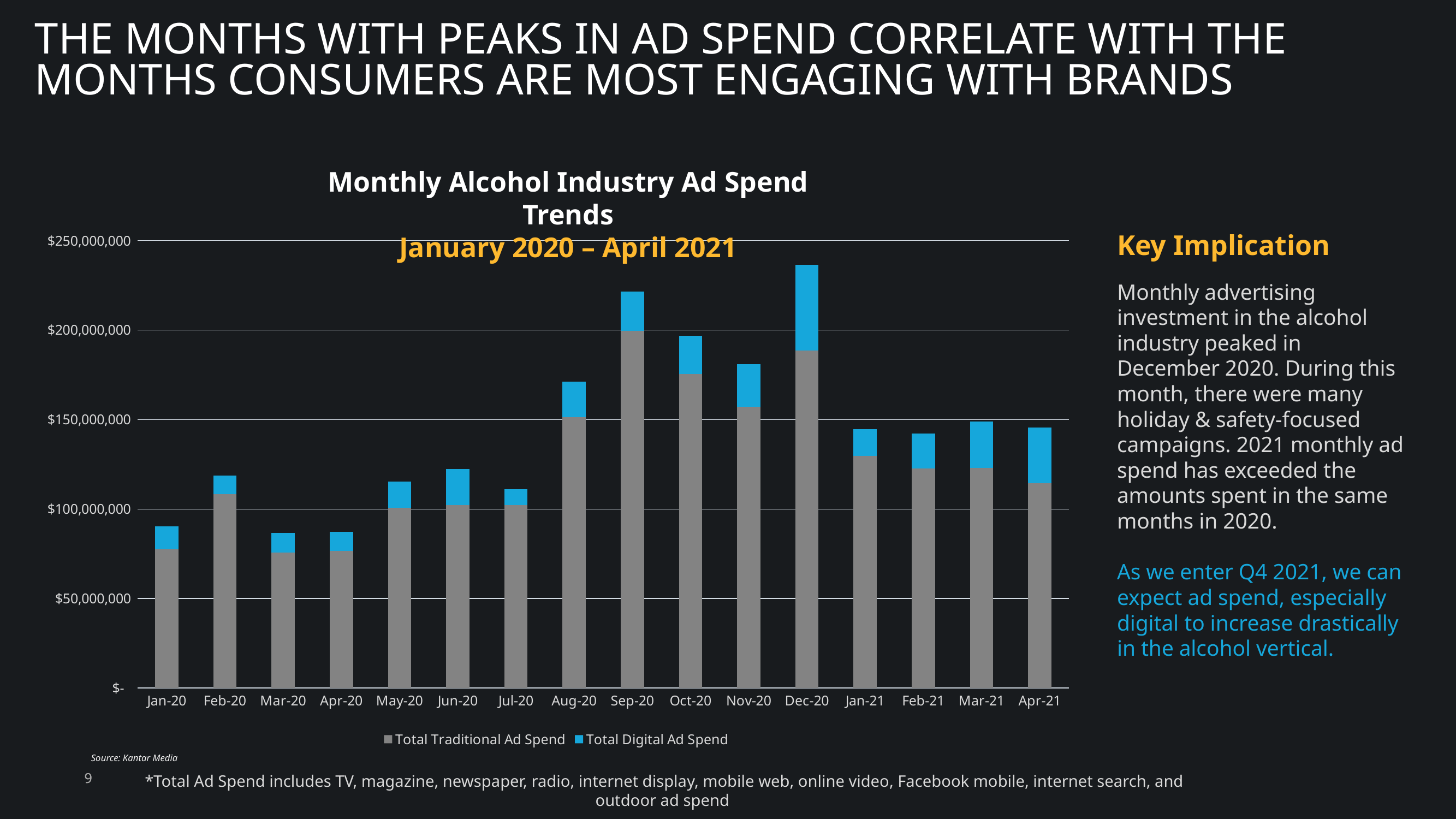
What kind of chart is shown on the slide? Stacked bar chart Does total ad spend rise or fall from Dec-20 to Jan-21? Fall Is the total ad spend for Aug-20 greater or less than $150,000,000? greater Which month has the larger total ad spend, Jan-20 or Feb-20? Feb-20 Is the total ad spend for Jan-20 greater or less than $100,000,000? less Which series is shown in blue in the chart? Total Digital Ad Spend Is the total ad spend for Dec-20 greater or less than $200,000,000? greater How many months are plotted on the x axis of the chart? 16 Which month has the larger total ad spend, Sep-20 or Oct-20? Sep-20 How many series does the chart's legend list? 2 Which month has the highest total ad spend in the chart? Dec-20